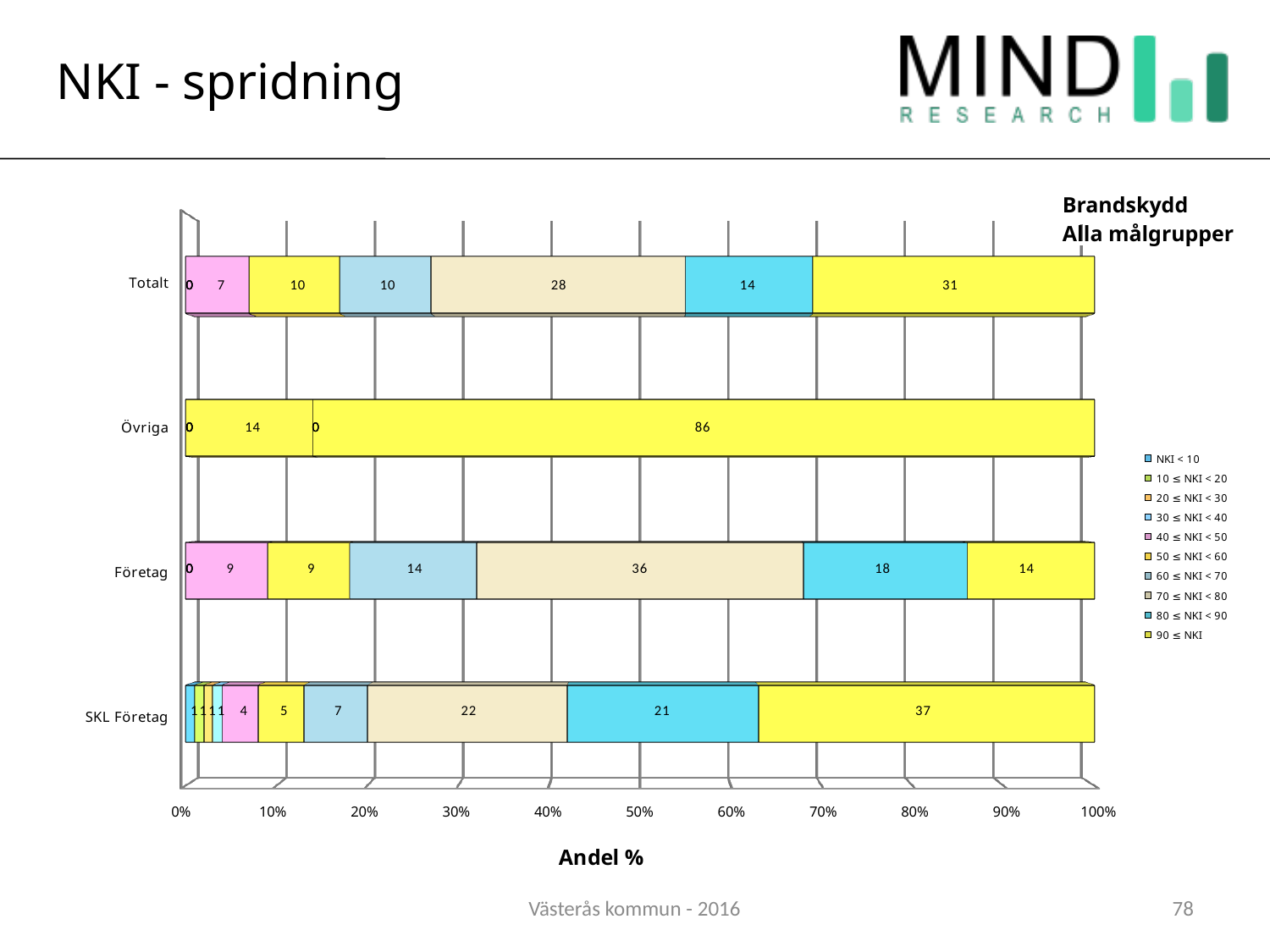
What kind of chart is shown on the slide? bar chart How many series does the legend list? 10 What is the value of the rightmost segment of the Totalt bar? 31 What is the title of the horizontal axis? Andel % What is the value of the largest segment in the Företag bar? 36 What text appears in the top-right corner of the chart area? Brandskydd Alla målgrupper How many categories are shown on the vertical axis of the chart? 4 What is the value of the rightmost segment of the Övriga bar? 86 What is the value of the rightmost segment of the SKL Företag bar? 37 What is the difference between the two non-zero segments of the Övriga bar (86 and 14)? 72 Which category contains the largest single segment in the chart? Övriga Which bar has the larger rightmost segment, Totalt or Företag? Totalt